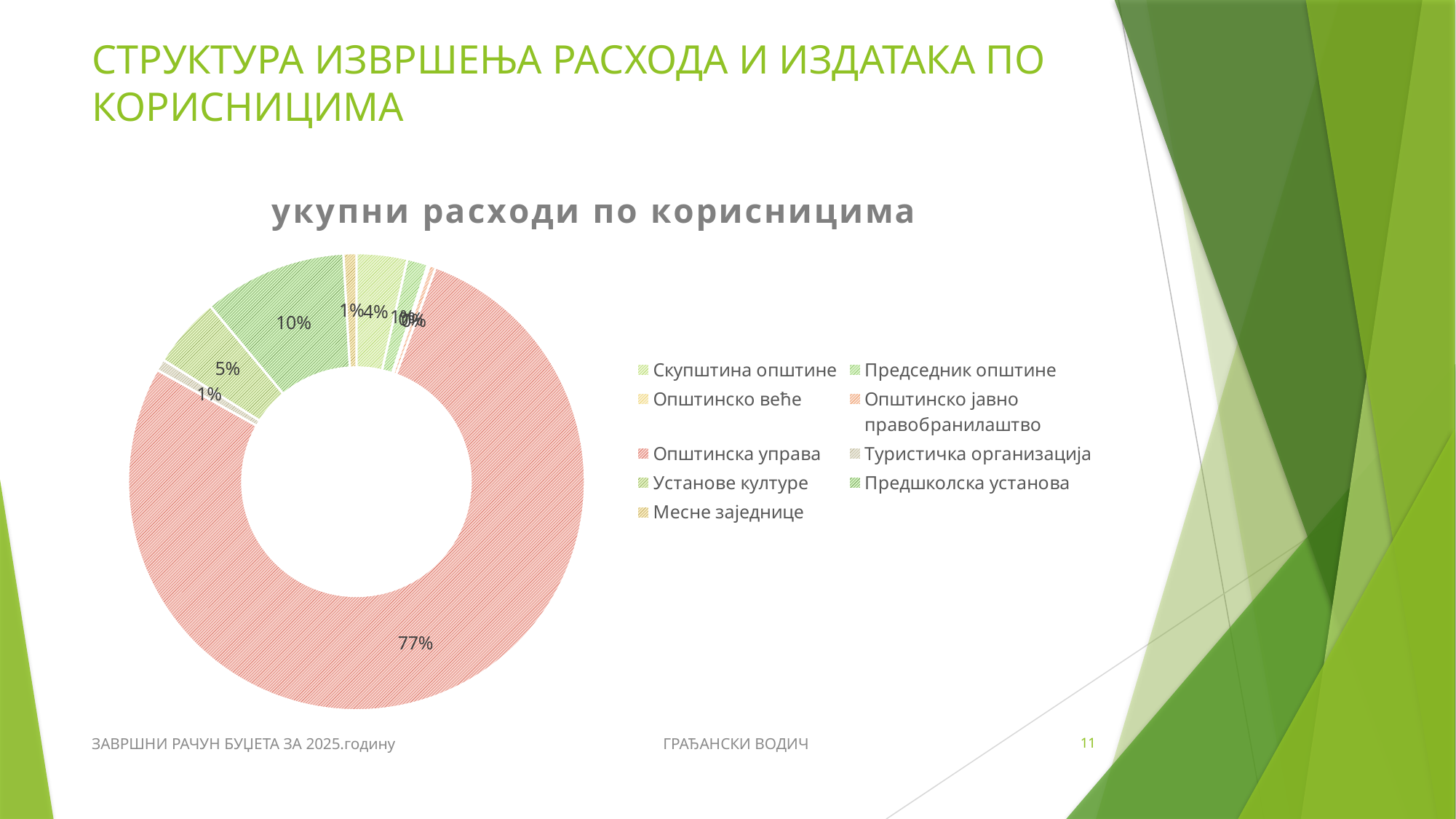
What percentage is shown for Установе културе? 5% Which legend entry is listed last in the chart's legend? Месне заједнице Which is larger, the share for Предшколска установа or the share for Установе културе? Предшколска установа What percentage is shown for Скупштина општине? 4% What percentage is shown for Туристичка организација? 1% What share of the chart does Предшколска установа account for? 10% How many categories does the chart's legend list? 9 What kind of chart is shown on the slide? Doughnut (pie) chart What is the title of the chart? укупни расходи по корисницима What is the difference in percentage points between the share for Општинска управа and the share for Предшколска установа? 67 percentage points What share of total expenditure is attributed to Општинска управа? 77% Which category has the largest share of the chart? Општинска управа